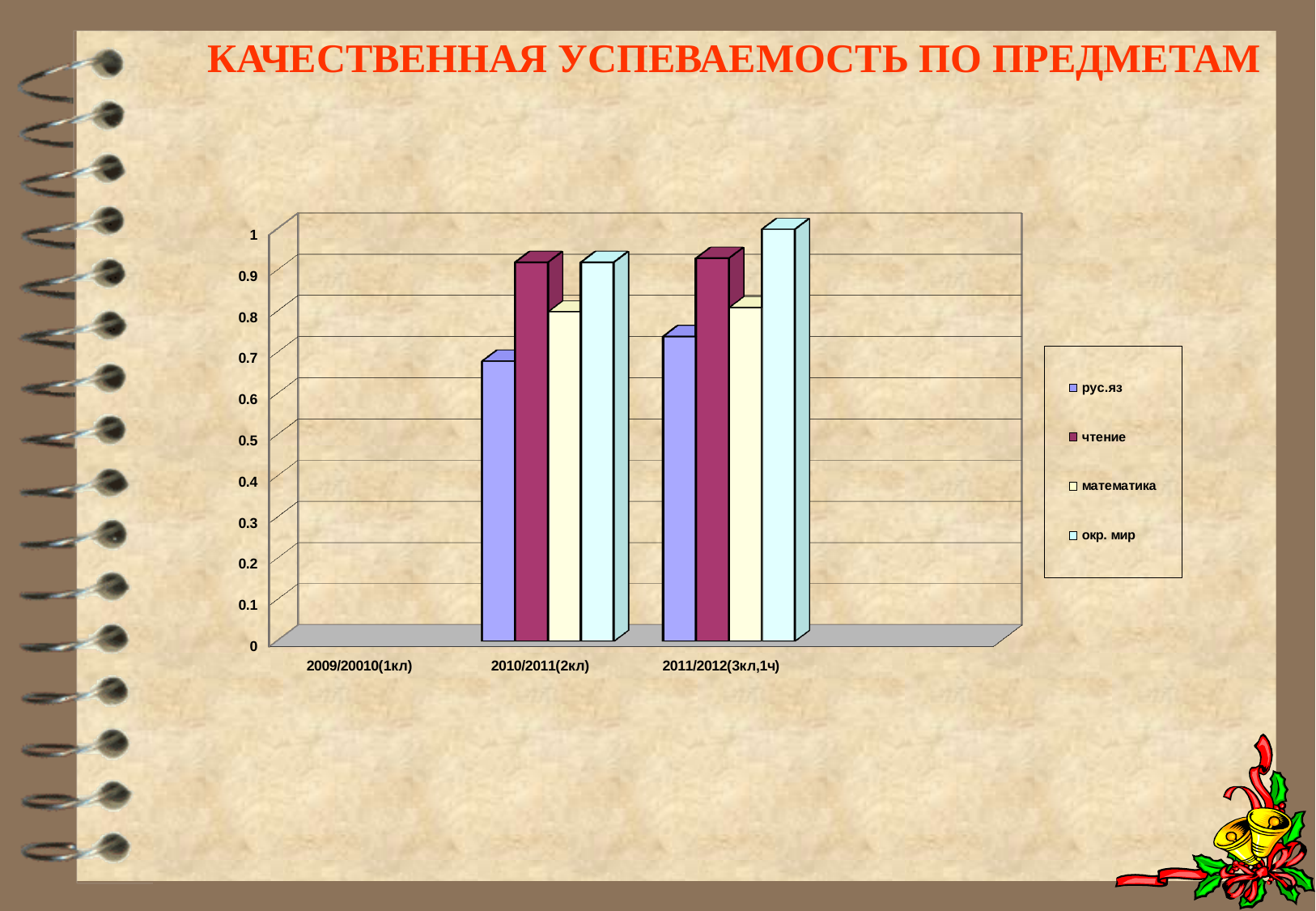
What is the title of the chart? КАЧЕСТВЕННАЯ УСПЕВАЕМОСТЬ ПО ПРЕДМЕТАМ Is the value for чтение in 2010/2011(2кл) greater or less than 0.8? greater Which series is shown in dark purple in the legend? чтение Which is larger for рус.яз: the value in 2010/2011(2кл) or in 2011/2012(3кл,1ч)? 2011/2012(3кл,1ч) Is the value for рус.яз in 2011/2012(3кл,1ч) greater or less than 0.8? less What kind of chart is shown on the slide? bar chart Which series has the lowest value in 2010/2011(2кл)? рус.яз Is the value for рус.яз in 2010/2011(2кл) greater or less than 0.6? greater How many series does the legend list? 4 Which series has the highest value in 2011/2012(3кл,1ч)? окр. мир How many categories are shown on the x axis? 3